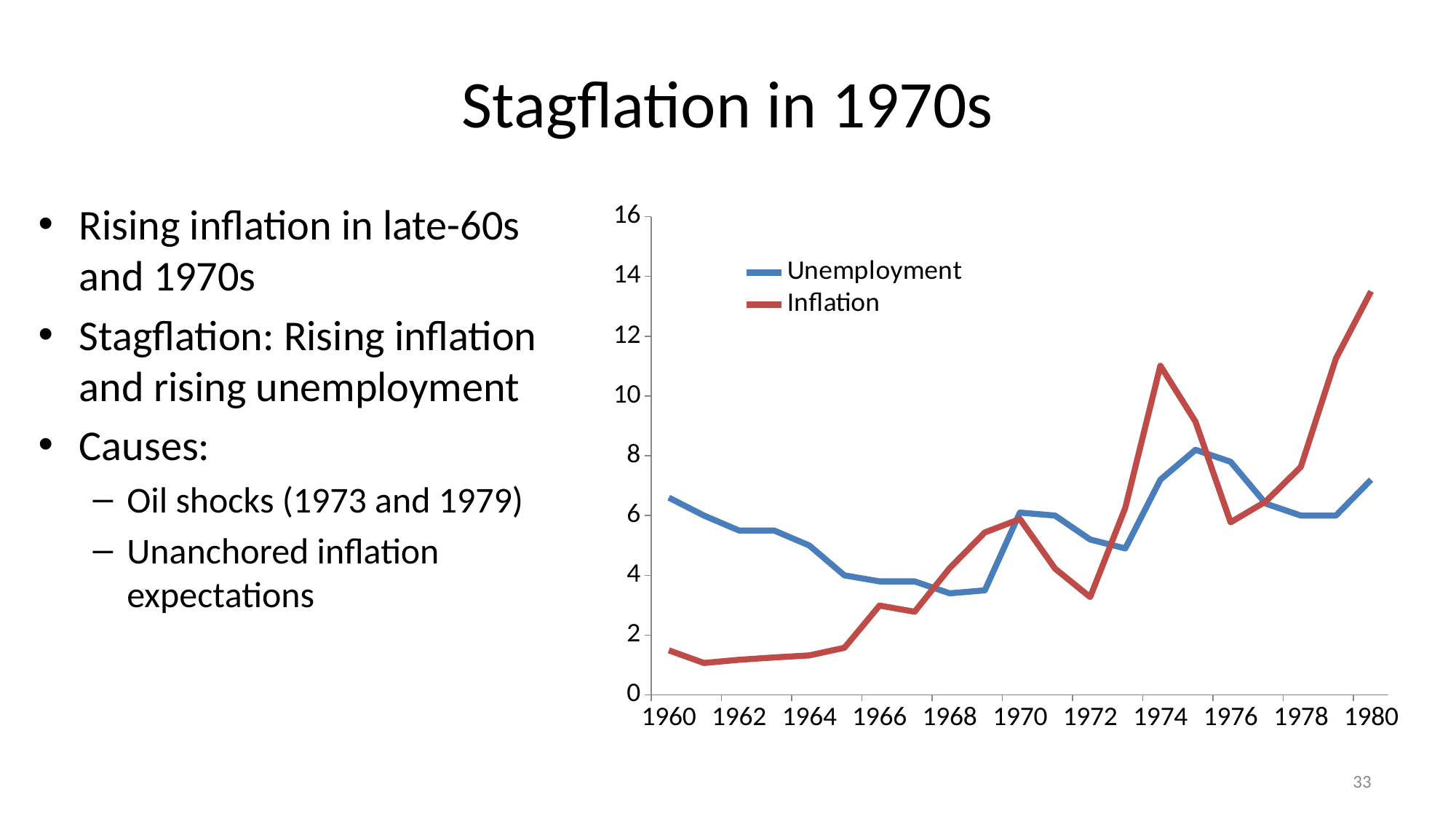
Is the Inflation value for 1961 greater or less than 2? less Does the Inflation line rise or fall between 1976 and 1980? Rise In which year does the Inflation line reach its highest value? 1980 Is the Inflation value for 1974 greater or less than 10? greater Which colour is used for the Inflation line? Red What kind of chart is shown on the slide? Line chart Is the Unemployment value for 1968 greater or less than 4? less In 1974, which series has the higher value, Unemployment or Inflation? Inflation In 1960, which series has the higher value, Unemployment or Inflation? Unemployment In which year does the Unemployment line reach its highest value? 1975 What are the two series named in the chart's legend? Unemployment and Inflation How many series does the chart's legend list? 2